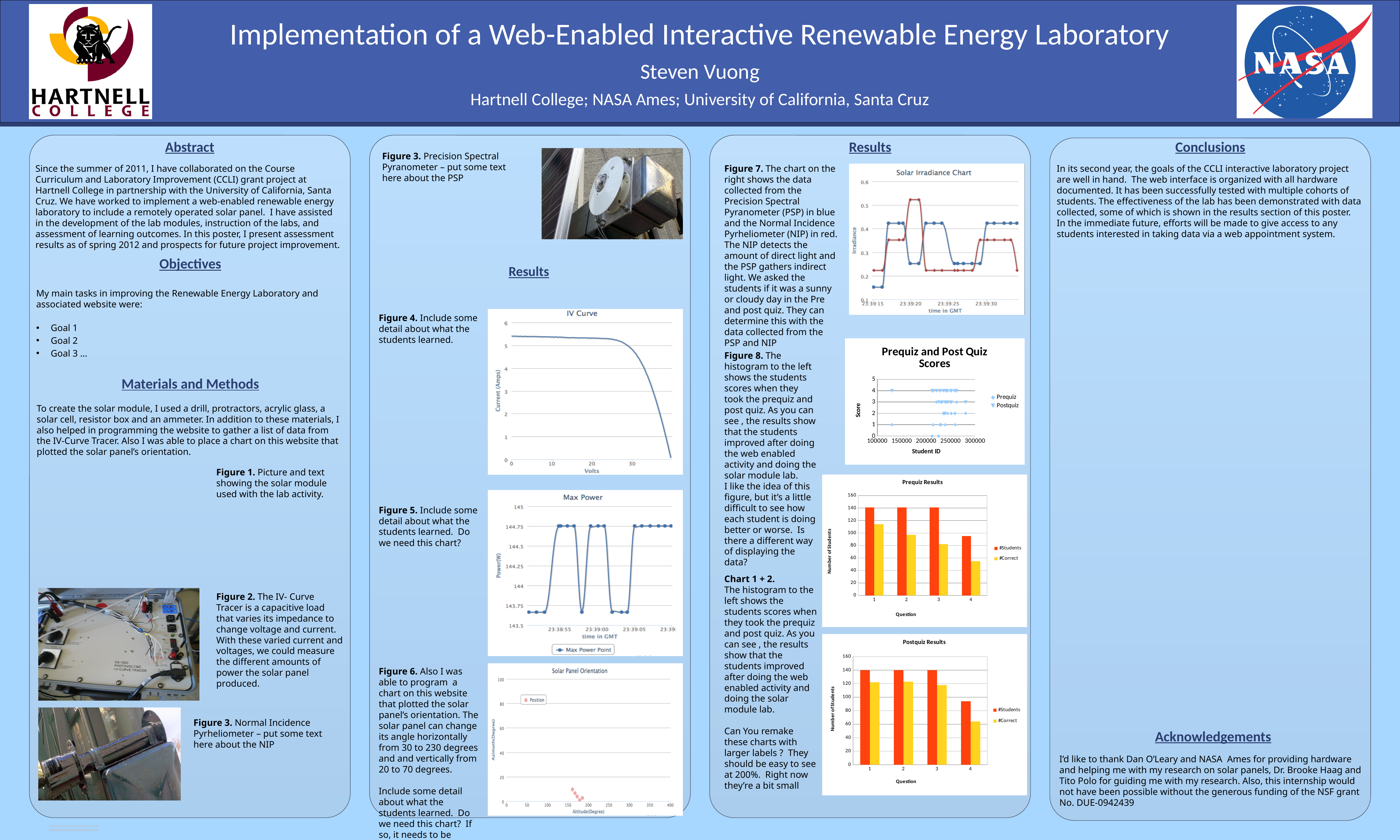
In the 'Prequiz Results' chart, is the #Correct value for question 4 greater or less than 80? less In the 'Postquiz Results' chart, is the #Correct value for question 1 greater or less than 100? greater How many series does the legend of the 'Prequiz and Post Quiz Scores' chart list? 2 What kind of chart is the 'Prequiz Results' chart? bar chart What kind of chart is the 'IV Curve' chart? line chart How many questions are shown on the x axis of the 'Postquiz Results' chart? 4 How many series does the legend of the 'Postquiz Results' chart list? 2 In the 'Prequiz Results' chart, which question has the lowest #Correct value? 4 What is the x-axis label of the 'Solar Panel Orientation' chart? Altitude(Degree) What is the legend entry shown on the 'Max Power' chart? Max Power Point In the 'Postquiz Results' chart, which is larger: the #Students value for question 1 or for question 4? question 1 In the 'Prequiz Results' chart, do the #Correct values rise or fall from question 1 to question 4? fall